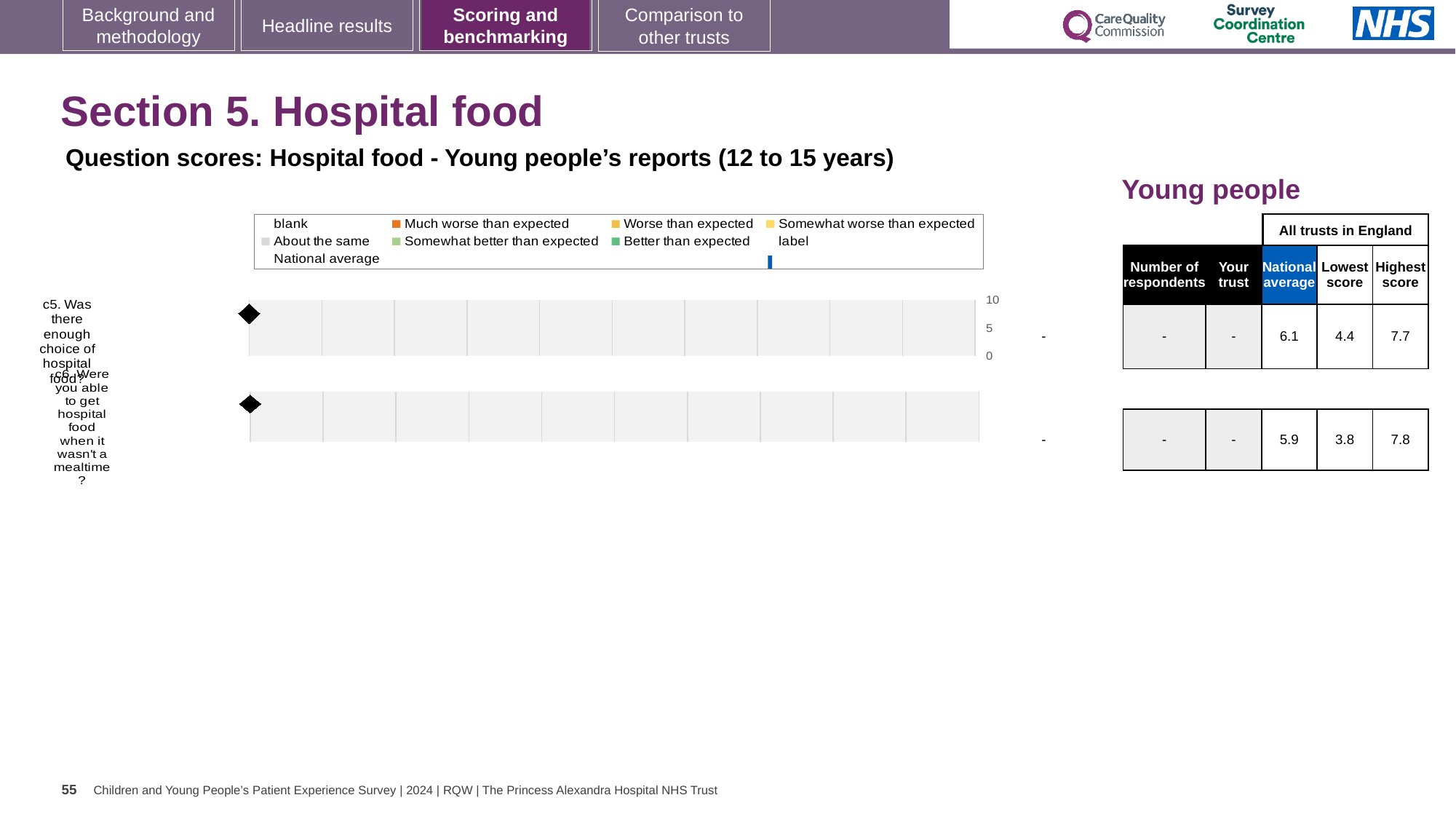
In the table beside the chart, which question has the higher national average, c5 or c6? c5 In the table beside the chart, what is the national average score for c6? 5.9 In the table beside the chart, what is the highest score for c5? 7.7 What colour does the legend use for 'Much worse than expected'? orange In the table beside the chart, what is the national average score for c5 'Was there enough choice of hospital food?'? 6.1 In the table beside the chart, what is the lowest score for c6 'Were you able to get hospital food when it wasn't a mealtime?'? 3.8 What is the highest tick value shown on the chart's score axis? 10 What kind of chart is used to show the question scores for c5 and c6? bar chart How many questions (categories) are plotted on the chart? 2 In the table beside the chart, what is the difference between the highest score and the lowest score for c5? 3.3 In the table beside the chart, what is shown in the 'Your trust' column for c5? - How many entries does the chart legend list? 9